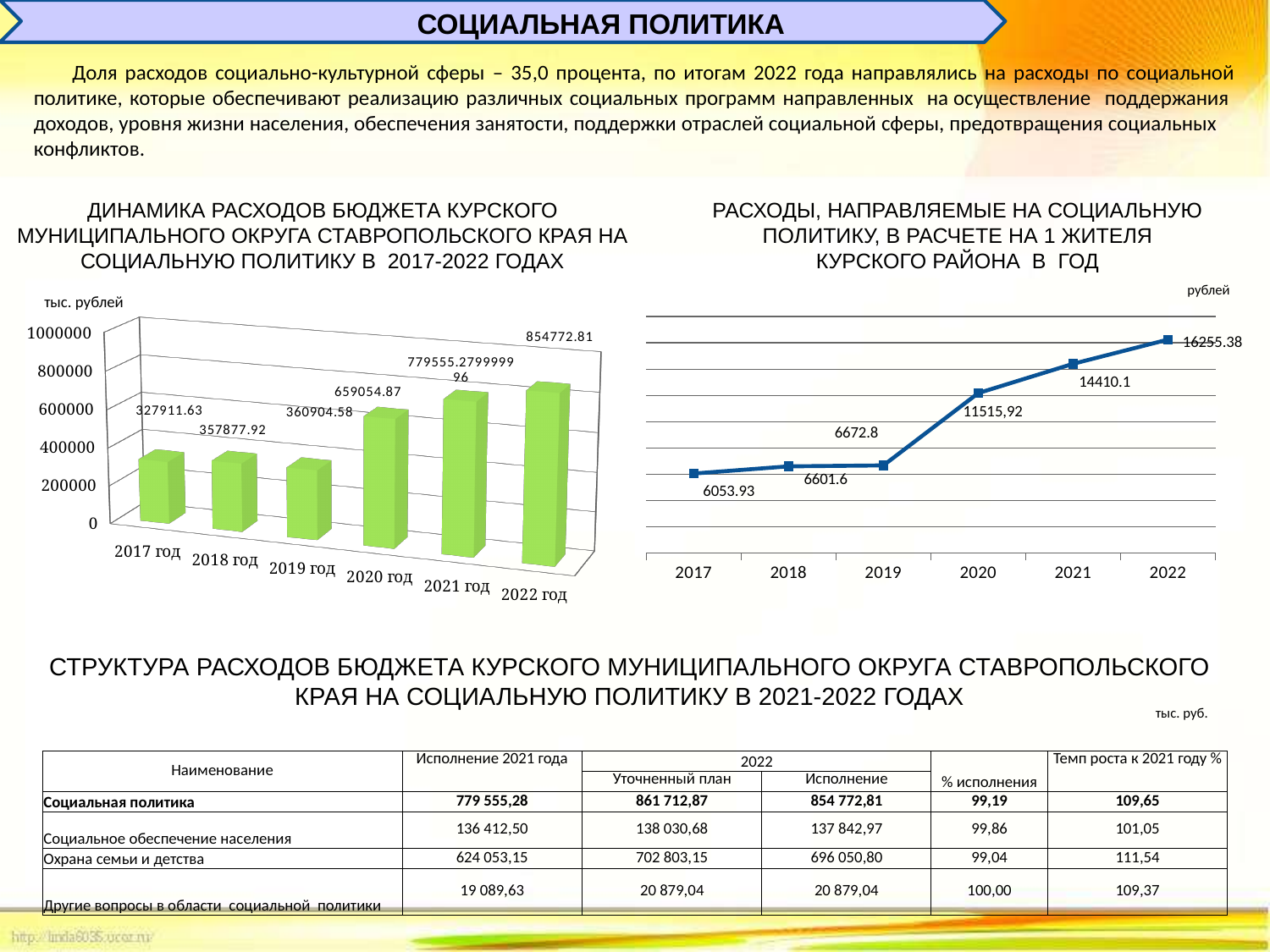
In the right chart (Расходы, направляемые на социальную политику, в расчете на 1 жителя), which year has the highest value? 2022 In the left chart (Динамика расходов бюджета ... на социальную политику в 2017-2022 годах), what is the value for 2022 год? 854772.81 In the right chart (Расходы, направляемые на социальную политику, в расчете на 1 жителя), do the values rise or fall from 2017 to 2022? rise In the left chart (Динамика расходов бюджета ... на социальную политику), what is the value for 2020 год? 659054.87 In the right chart (Расходы, направляемые на социальную политику, в расчете на 1 жителя), what kind of chart is it? line chart In the right chart (Расходы, направляемые на социальную политику, в расчете на 1 жителя), what is the value for 2021? 14410.1 In the left chart (Динамика расходов бюджета ... на социальную политику), which year has the lowest value? 2017 год In the left chart (Динамика расходов бюджета ... на социальную политику), what is the value for 2017 год? 327911.63 In the left chart (Динамика расходов бюджета ... на социальную политику), what is the difference between the values for 2022 год and 2017 год? 526861.18 In the right chart (Расходы, направляемые на социальную политику, в расчете на 1 жителя), what is the value for 2017? 6053.93 In the left chart (Динамика расходов бюджета ... на социальную политику), what kind of chart is it? bar chart In the left chart (Динамика расходов бюджета ... на социальную политику), how many years are shown? 6